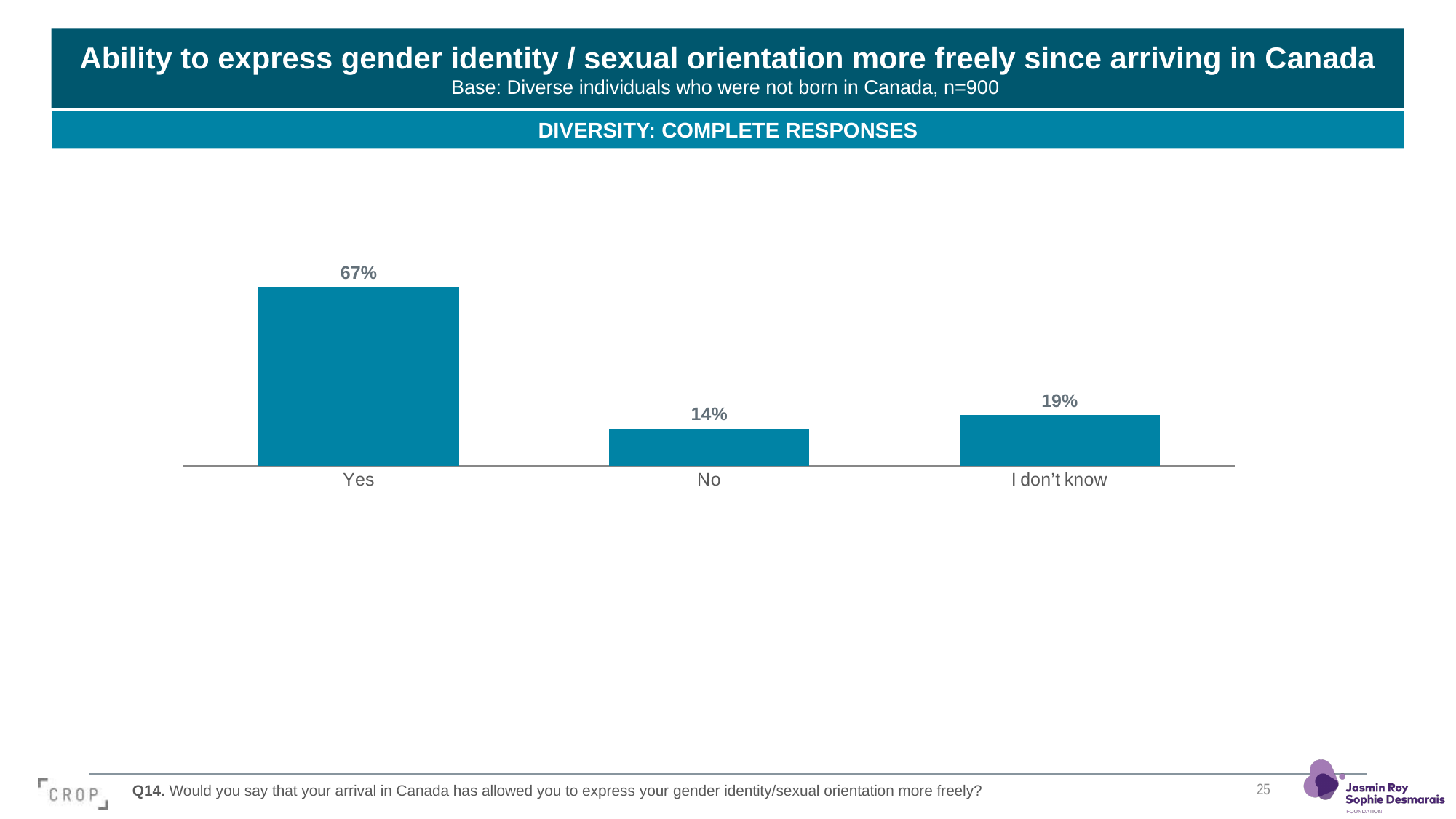
What is the difference in percentage points between "I don't know" and "No"? 5 Which is larger, the value for "No" or the value for "I don't know"? I don't know Which response category has the highest value? Yes Which response category has the lowest value? No What is the base size (n) stated in the chart title? n=900 What percentage of respondents answered "I don't know"? 19% What is the total of the three percentages shown in the chart? 100% What percentage of respondents answered "No"? 14% What percentage of respondents answered "Yes"? 67% How many response categories are shown in the chart? 3 What is the difference in percentage points between "Yes" and "No"? 53 What kind of chart is shown on the slide? Bar chart